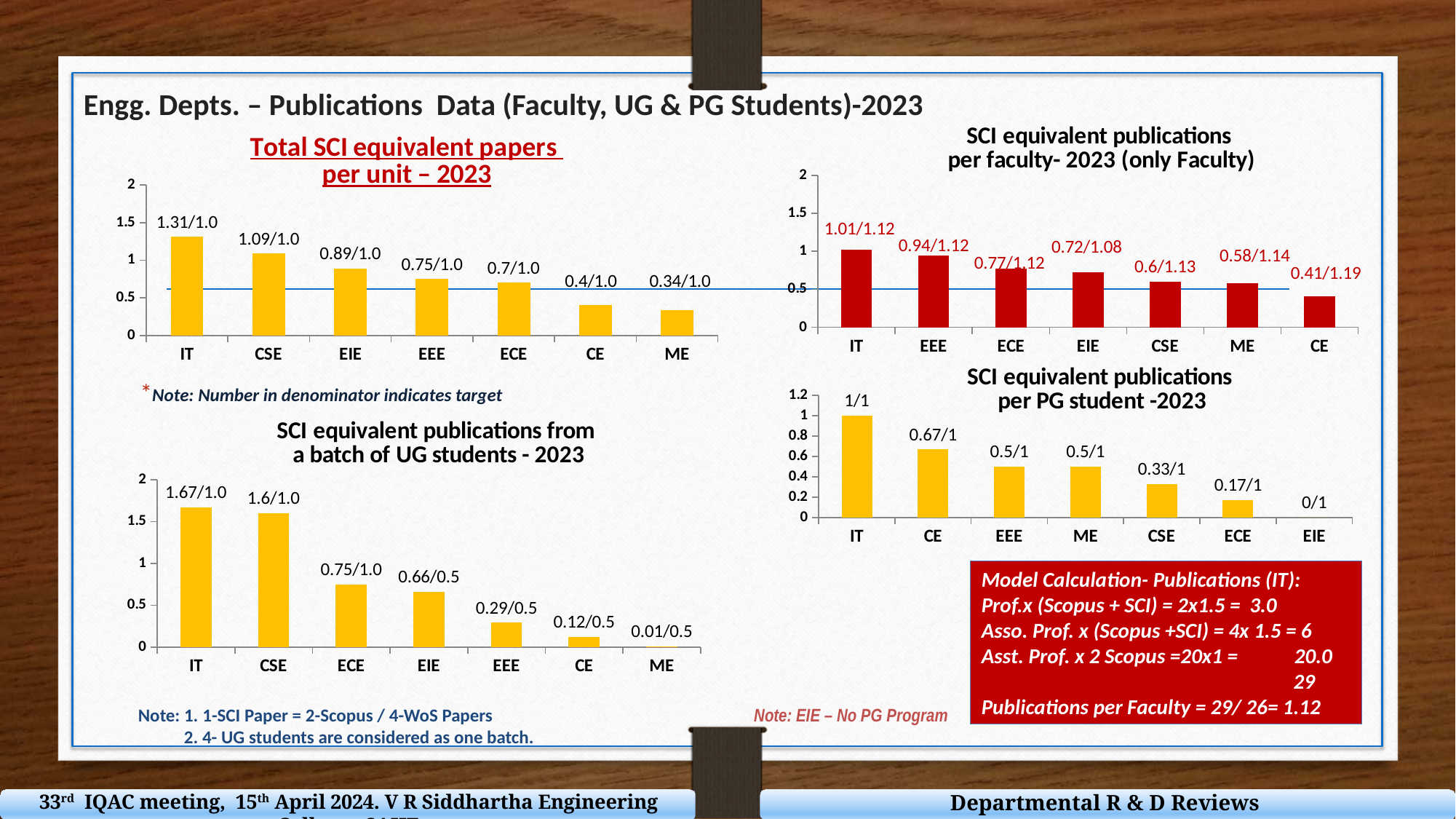
In the 'SCI equivalent publications from a batch of UG students - 2023' chart, what is the data label shown for EIE? 0.66/0.5 In the 'SCI equivalent publications per PG student -2023' chart, what is the data label shown for CSE? 0.33/1 In the 'Total SCI equivalent papers per unit – 2023' chart, what is the data label shown for IT? 1.31/1.0 In the 'Total SCI equivalent papers per unit – 2023' chart, which department has the lowest bar? ME In the 'Total SCI equivalent papers per unit – 2023' chart, how many departments are plotted? 7 In the 'SCI equivalent publications per faculty- 2023 (only Faculty)' chart, is the bar for EEE larger or smaller than the bar for CE? larger In the 'SCI equivalent publications from a batch of UG students - 2023' chart, which department has the lowest bar? ME In the 'SCI equivalent publications per PG student -2023' chart, which department has the highest bar? IT In the 'SCI equivalent publications per faculty- 2023 (only Faculty)' chart, what is the data label shown for ECE? 0.77/1.12 In the 'SCI equivalent publications from a batch of UG students - 2023' chart, do the bars rise or fall from left to right? fall In the 'SCI equivalent publications per faculty- 2023 (only Faculty)' chart, which department has the highest bar? IT What type of chart is the 'SCI equivalent publications per faculty- 2023 (only Faculty)' chart? bar chart